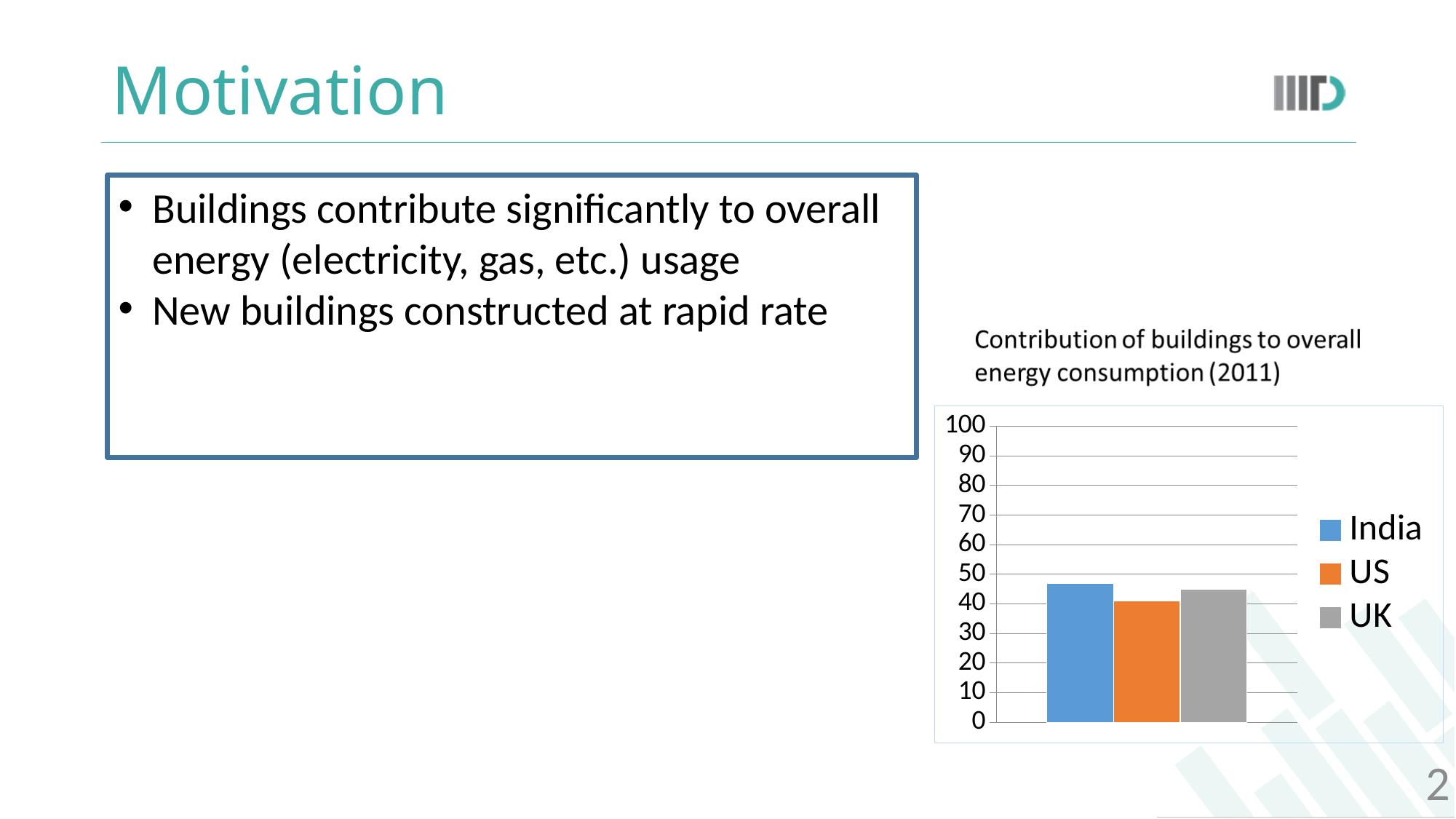
Which is larger in the chart, the value for UK or the value for US? UK What is the title of the chart? Contribution of buildings to overall energy consumption (2011) Which colour represents US in the chart? orange Is the value for US greater or less than 50? less Which series has the lowest bar in the chart? US Is the value for UK greater or less than 40? greater Which series has the highest bar in the chart? India Is the value for India greater or less than 50? less Which is larger in the chart, the value for India or the value for US? India What kind of chart is shown on the slide? bar chart How many series does the legend of the chart list? 3